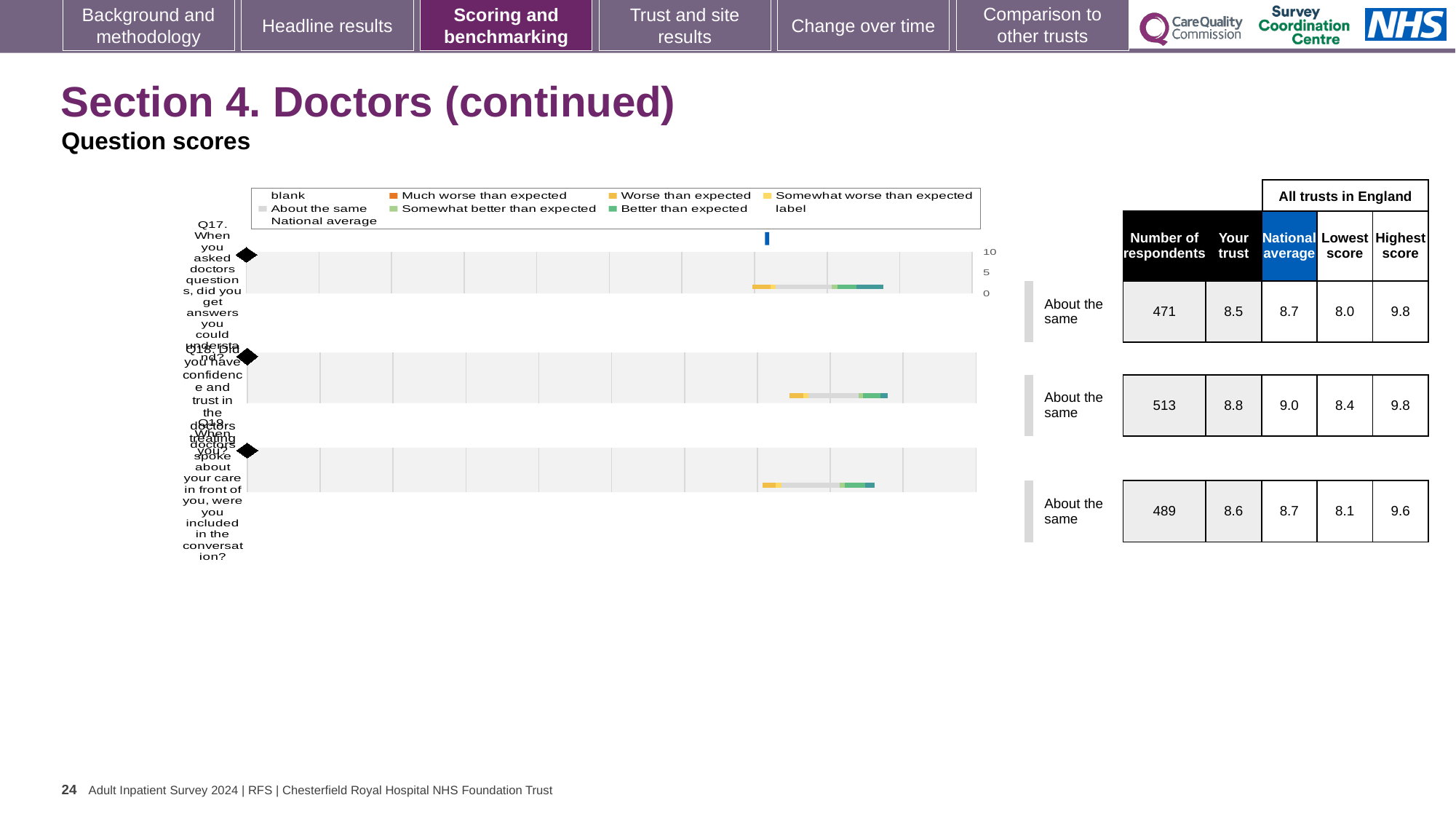
Which of the three questions has the highest 'Your trust' score? Q18 How many respondents answered Q19 (When doctors spoke about your care in front of you, were you included in the conversation?)? 489 What is the 'Your trust' score for Q17 (When you asked doctors questions, did you get answers you could understand?)? 8.5 What is the highest value shown on the score axis of the charts? 10 What benchmark category is shown for Q18? About the same What kind of chart is used to show the question scores for Q17, Q18 and Q19? bar chart What is the difference between the national average and the 'Your trust' score for Q17? 0.2 What is the national average score for Q18 (Did you have confidence and trust in the doctors treating you?)? 9.0 How many questions (Q17, Q18, Q19) are plotted on the slide? 3 According to the legend, which colour category is labelled 'Much worse than expected'? orange Which of the three questions has the lowest 'Lowest score' across all trusts in England? Q17 Is the 'Your trust' score for Q19 larger or smaller than the national average for Q19? smaller